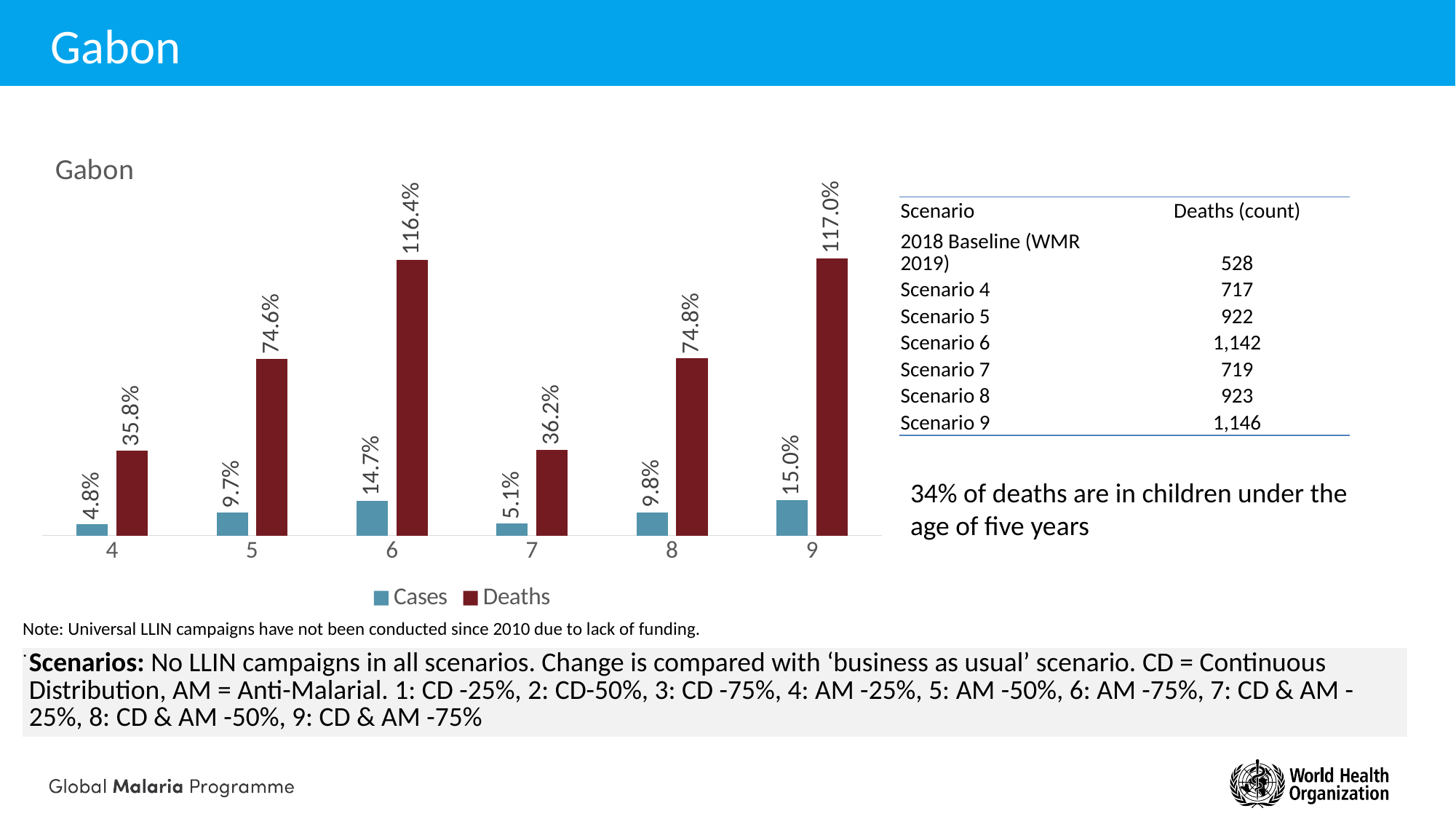
What is the value of the Deaths series for scenario 7? 36.2% What is the difference between the Deaths values for scenario 9 and scenario 6? 0.6% What is the value of the Cases series for scenario 9? 15.0% What is the difference between the Cases values for scenario 6 and scenario 5? 5.0% Which is larger, the Deaths value for scenario 5 or for scenario 8? Scenario 8 How many series does the chart legend list? 2 What is the value of the Deaths series for scenario 6? 116.4% Which scenario has the highest Deaths value? 9 What is the value of the Cases series for scenario 4? 4.8% Which scenario has the lowest Cases value? 4 What kind of chart is shown on the slide? Bar chart How many scenarios are shown on the x axis of the chart? 6